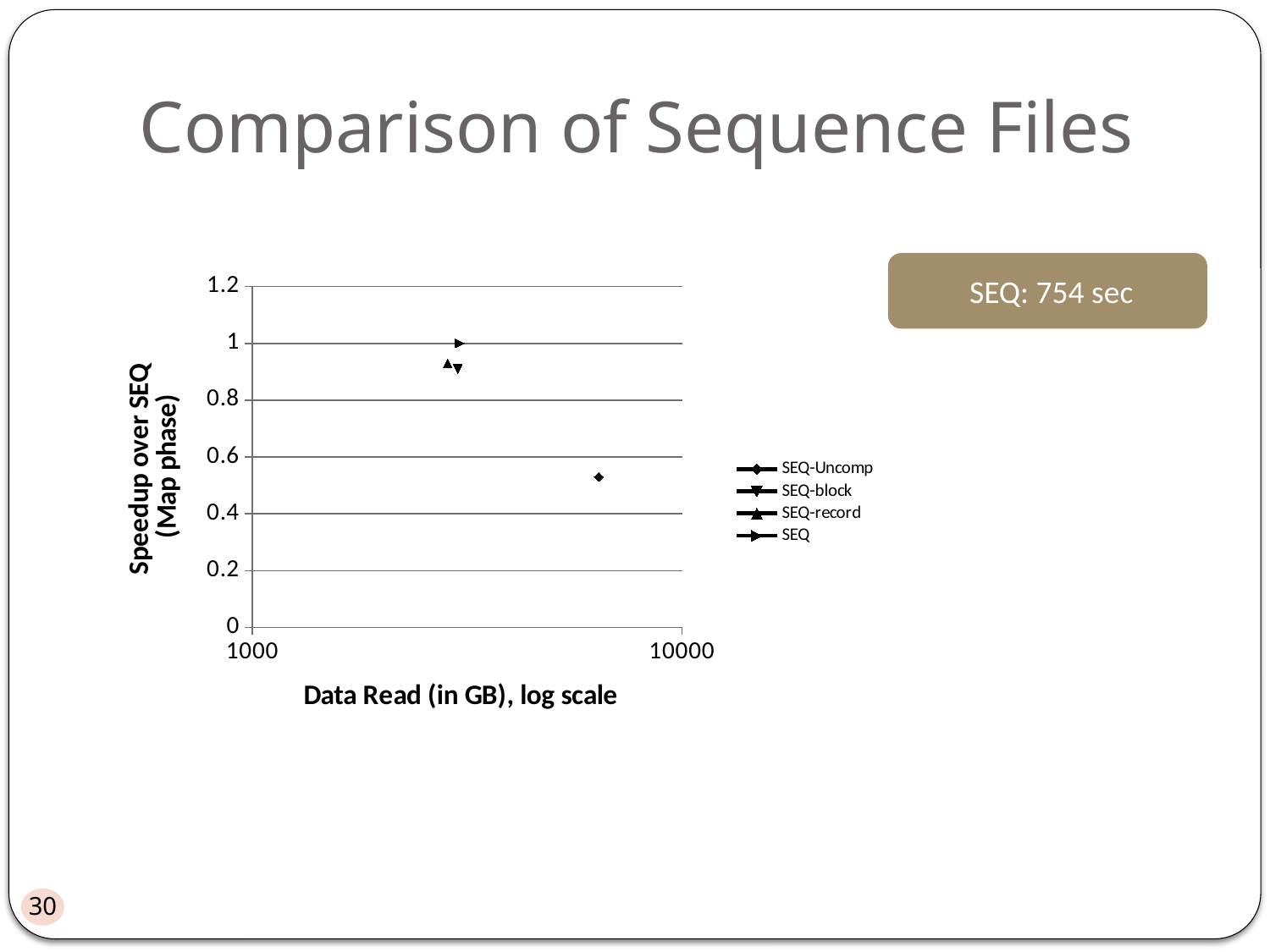
Which has the larger speedup over SEQ: SEQ or SEQ-record? SEQ What is the label of the y axis? Speedup over SEQ (Map phase) How many data points are plotted on the chart? 4 Is the speedup value for SEQ-Uncomp greater or less than 0.6? less Which series has the lowest speedup over SEQ? SEQ-Uncomp Is the speedup value for SEQ-block greater or less than 0.8? greater What is the label of the x axis? Data Read (in GB), log scale Which series has the highest speedup over SEQ? SEQ What kind of chart is shown on the slide? scatter chart How many series does the legend list? 4 Which has the larger speedup over SEQ: SEQ-Uncomp or SEQ-block? SEQ-block Is the speedup value for SEQ-Uncomp greater or less than 0.4? greater